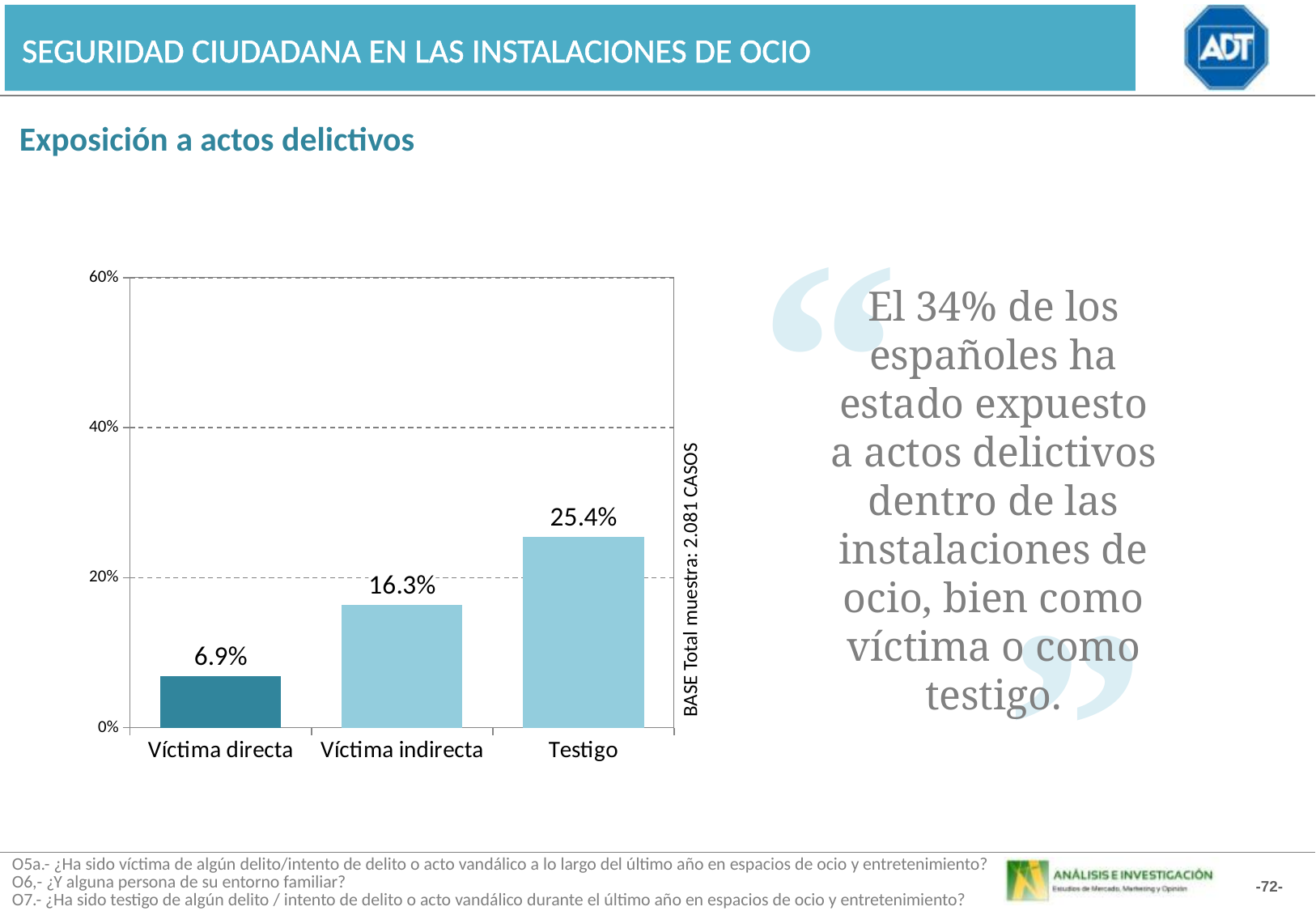
How many categories are shown on the x axis? 3 What is the value for Víctima indirecta? 16.3% Do the values rise or fall from left to right along the x axis? rise What is the difference between the values for Víctima indirecta and Víctima directa? 9.4% What is the value for Testigo? 25.4% Which is larger, the value for Víctima indirecta or the value for Víctima directa? Víctima indirecta Which category has the highest value? Testigo What kind of chart is shown on the slide? bar chart Which category has the lowest value? Víctima directa What is the value for Víctima directa? 6.9% Is the value for Testigo greater or less than 20%? greater What is the difference between the values for Testigo and Víctima indirecta? 9.1%